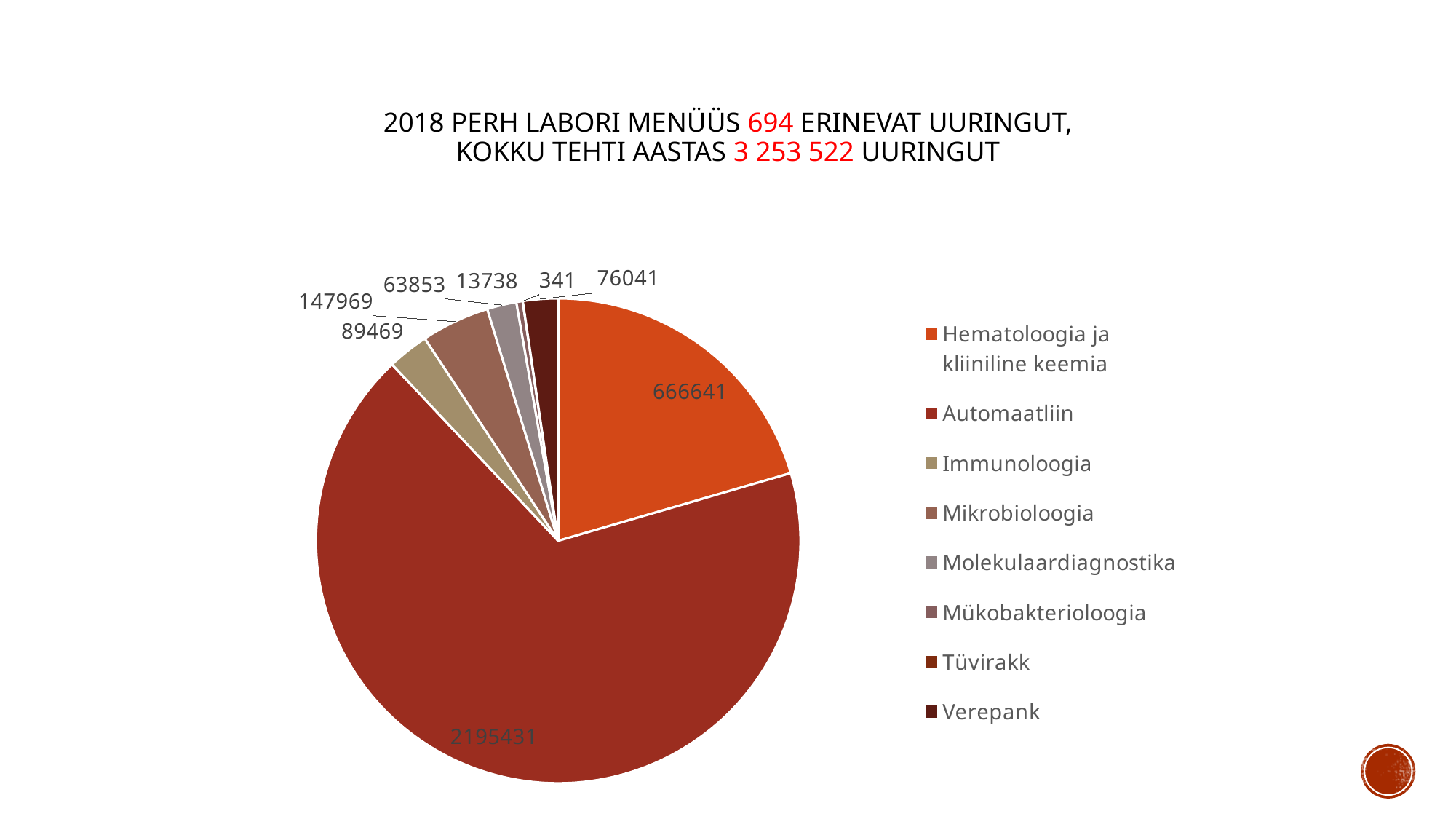
What is the value for Hematoloogia ja kliiniline keemia? 666641 What is the value for Mikrobioloogia? 147969 Which is larger, Immunoloogia or Mikrobioloogia? Mikrobioloogia What is the difference between the values for Mikrobioloogia and Immunoloogia? 58500 Which category has the smallest slice of the pie? Tüvirakk What kind of chart is shown on the slide? pie chart What is the difference between the values for Hematoloogia ja kliiniline keemia and Verepank? 590600 What is the value for Automaatliin? 2195431 What is the value for Verepank? 76041 How many categories does the legend of the pie chart list? 8 Which category has the largest slice of the pie? Automaatliin What is the value for Tüvirakk? 341